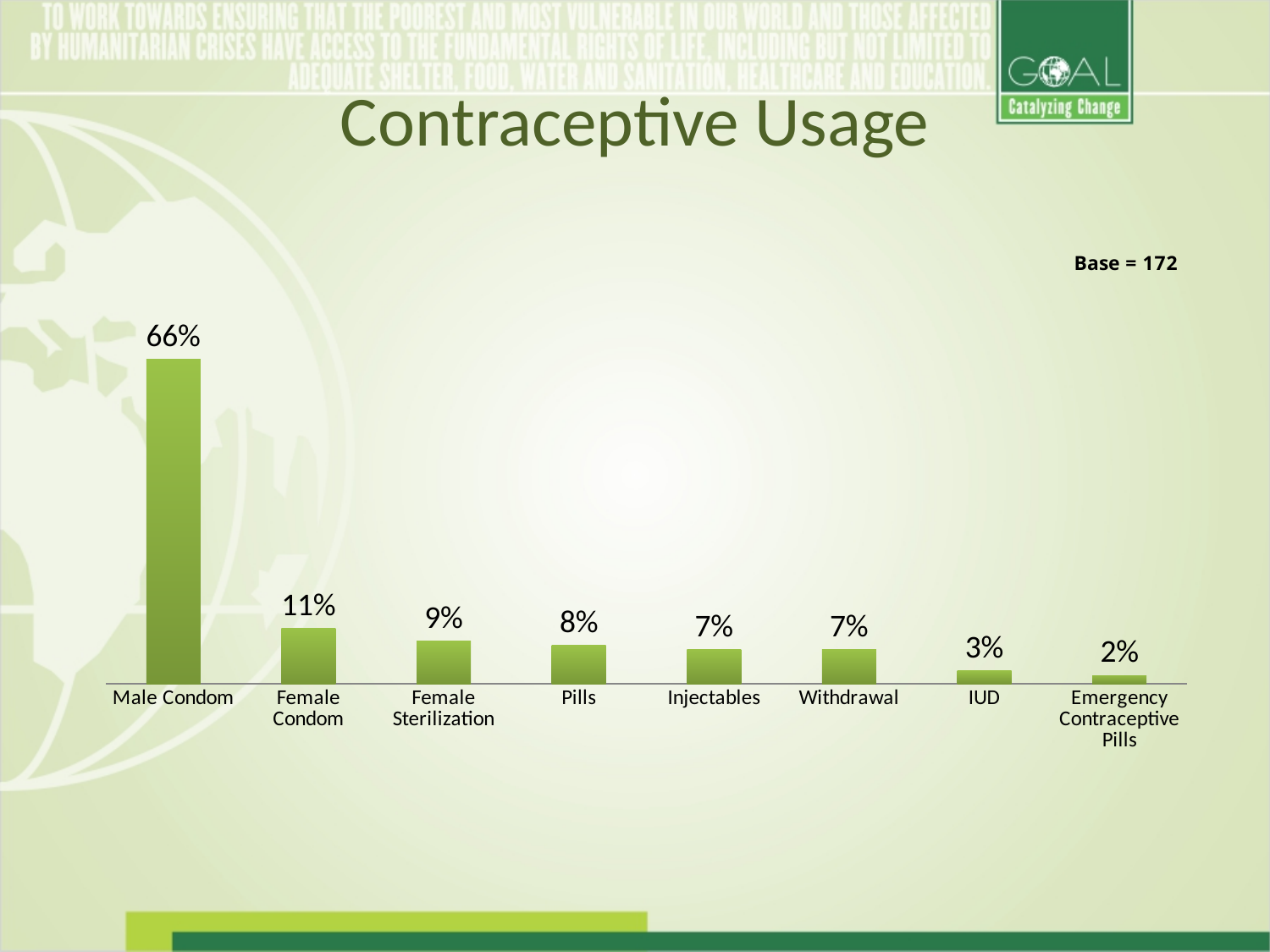
How many categories are shown in the chart? 8 What is the value for Emergency Contraceptive Pills? 2% Which is larger, the value for Female Condom or the value for Pills? Female Condom What kind of chart is shown on the slide? Bar chart What is the difference between the values for Pills and IUD? 5% Which category has the highest value? Male Condom What is the value for Male Condom? 66% Which category has the lowest value? Emergency Contraceptive Pills What is the value for Female Sterilization? 9% What is the difference between the values for Male Condom and Female Condom? 55% What is the value for IUD? 3% What is the base (sample size) noted on the chart? 172